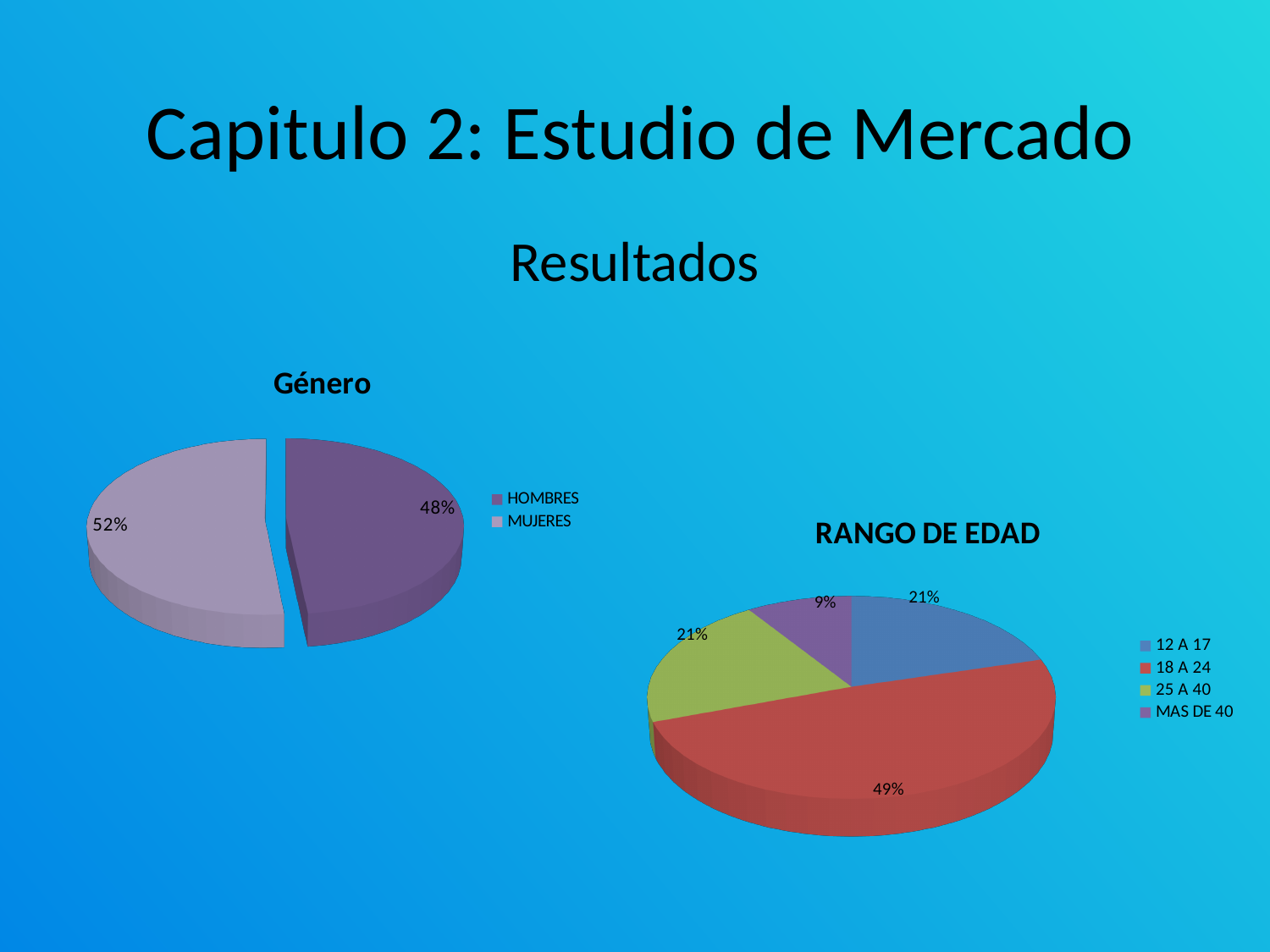
What is the title of the pie chart on the right side of the slide? RANGO DE EDAD What kind of chart is the Género chart? Pie chart In the RANGO DE EDAD chart, which age range has the largest share? 18 A 24 How many categories does the legend of the RANGO DE EDAD chart list? 4 In the Género chart, what is the difference in percentage points between MUJERES and HOMBRES? 4 In the RANGO DE EDAD chart, which age range has the smallest share? MAS DE 40 In the RANGO DE EDAD chart, what percentage is shown for MAS DE 40? 9% In the Género chart, which category has the larger share, HOMBRES or MUJERES? MUJERES In the Género chart, what percentage is shown for MUJERES? 52% In the RANGO DE EDAD chart, what percentage is shown for 18 A 24? 49% In the RANGO DE EDAD chart, what is the difference in percentage points between 18 A 24 and MAS DE 40? 40 In the Género chart, what percentage is shown for HOMBRES? 48%